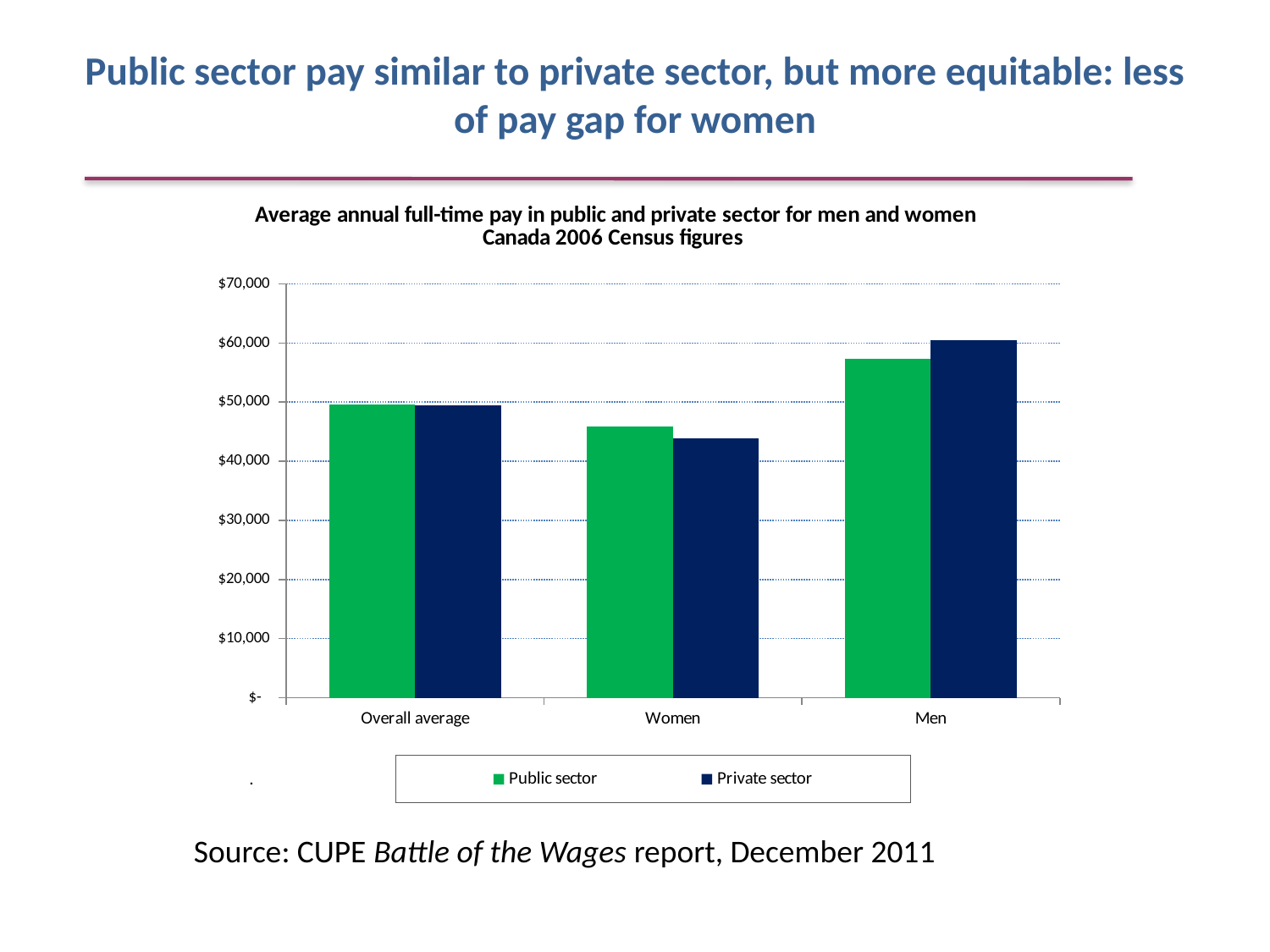
Is the Private sector value for Women greater or less than $50,000? less For Men, which is larger: the Public sector value or the Private sector value? Private sector Which category has the highest Public sector value? Men Is the Public sector value for Men greater or less than $60,000? less How many categories are shown on the x axis of the chart? 3 Which category has the highest Private sector value? Men Which category has the lowest Private sector value? Women How many series does the chart's legend list? 2 What kind of chart is shown on the slide? Bar chart For Women, which is larger: the Public sector value or the Private sector value? Public sector Which category has the lowest Public sector value? Women Which colour represents the Private sector series in the chart? Dark blue